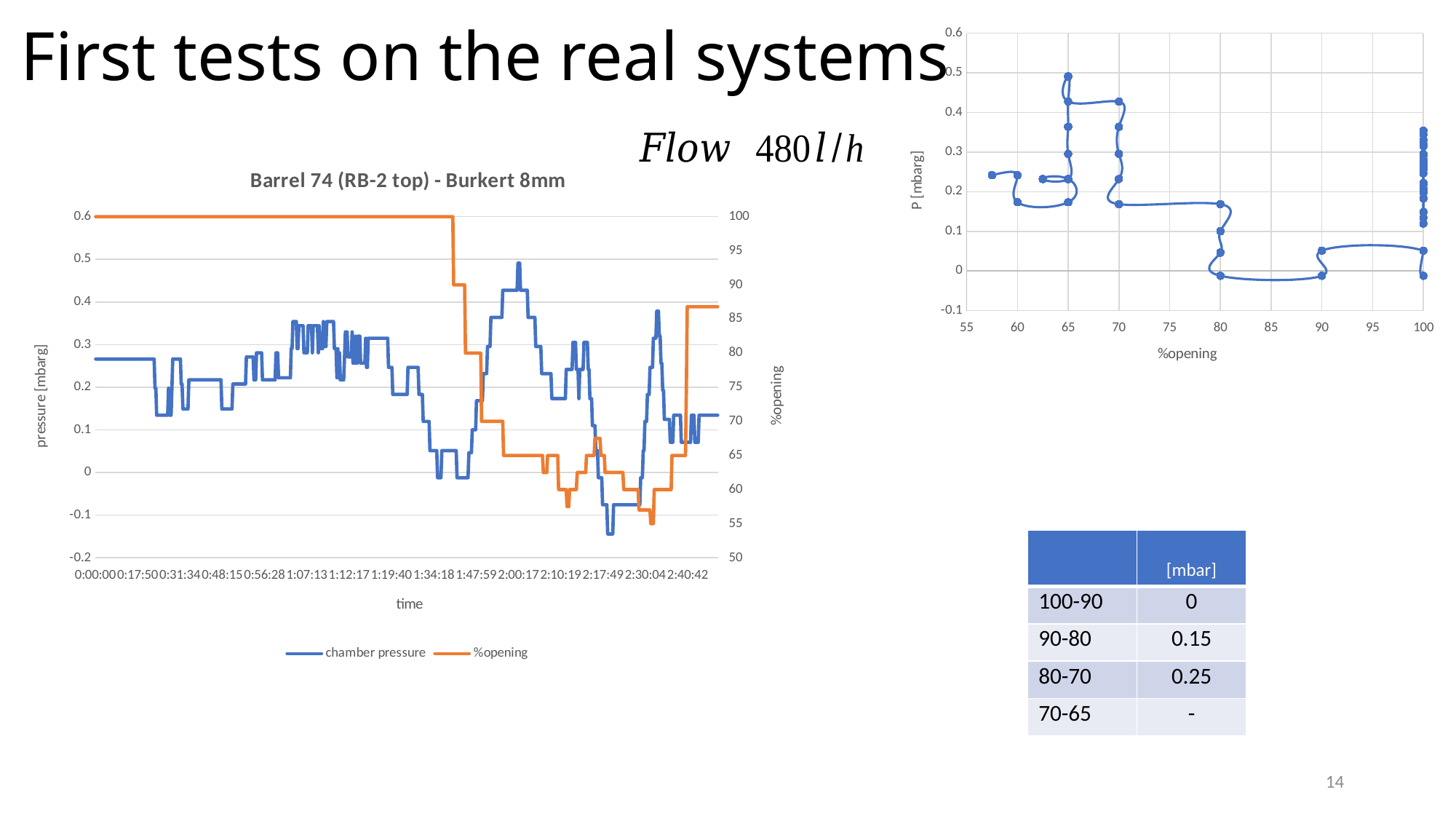
In the 'Barrel 74 (RB-2 top) - Burkert 8mm' chart, is the chamber pressure at time 0:00:00 greater or less than 0.2? greater In the chart on the right of the slide, are the P [mbarg] values at %opening 90 greater or less than 0.1? less What is the x-axis label of the chart on the right of the slide? %opening What are the two series named in the legend of the 'Barrel 74 (RB-2 top) - Burkert 8mm' chart? chamber pressure and %opening How many series does the legend of the 'Barrel 74 (RB-2 top) - Burkert 8mm' chart list? 2 In the 'Barrel 74 (RB-2 top) - Burkert 8mm' chart, is the highest chamber pressure peak near 2:00:17 greater or less than 0.4? greater In the 'Barrel 74 (RB-2 top) - Burkert 8mm' chart, does the %opening series overall rise or fall from the start of the time axis to 2:30:04? fall What kind of chart is the 'Barrel 74 (RB-2 top) - Burkert 8mm' chart on the left? line chart What kind of chart is the chart on the right of the slide, plotting P [mbarg] against %opening? scatter chart